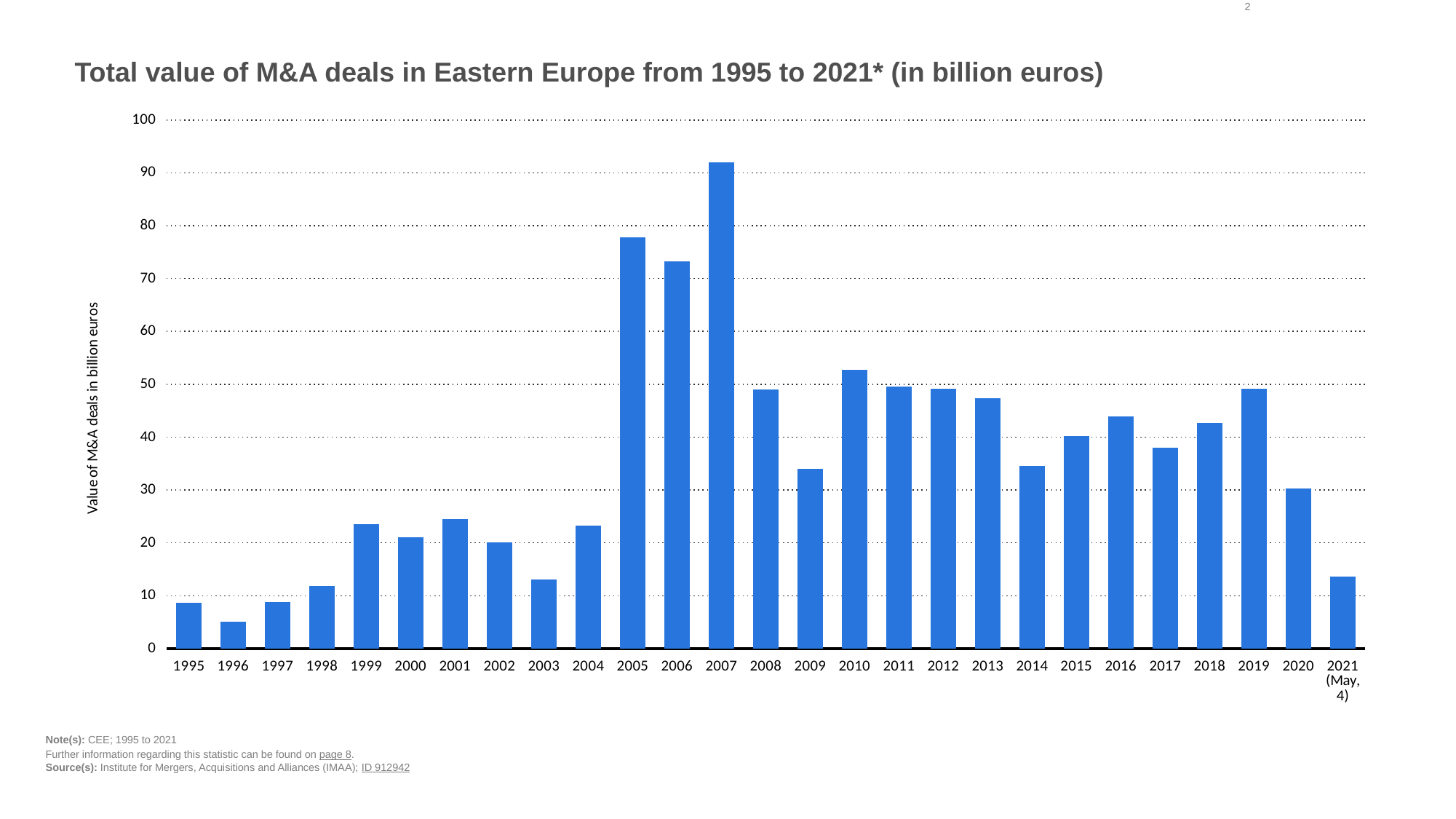
Which year has the lowest total value of M&A deals? 1996 Is the value for 2003 greater or less than 20? less Which year has the highest total value of M&A deals? 2007 Which year has the larger value, 2005 or 2006? 2005 What kind of chart is shown on the slide? bar chart Is the value for 2007 greater or less than 90? greater Do the values rise or fall from 2007 to 2009? fall How many years (bars) are plotted in the chart? 27 What is the label of the vertical axis? Value of M&A deals in billion euros Is the value for 2014 greater or less than 40? less